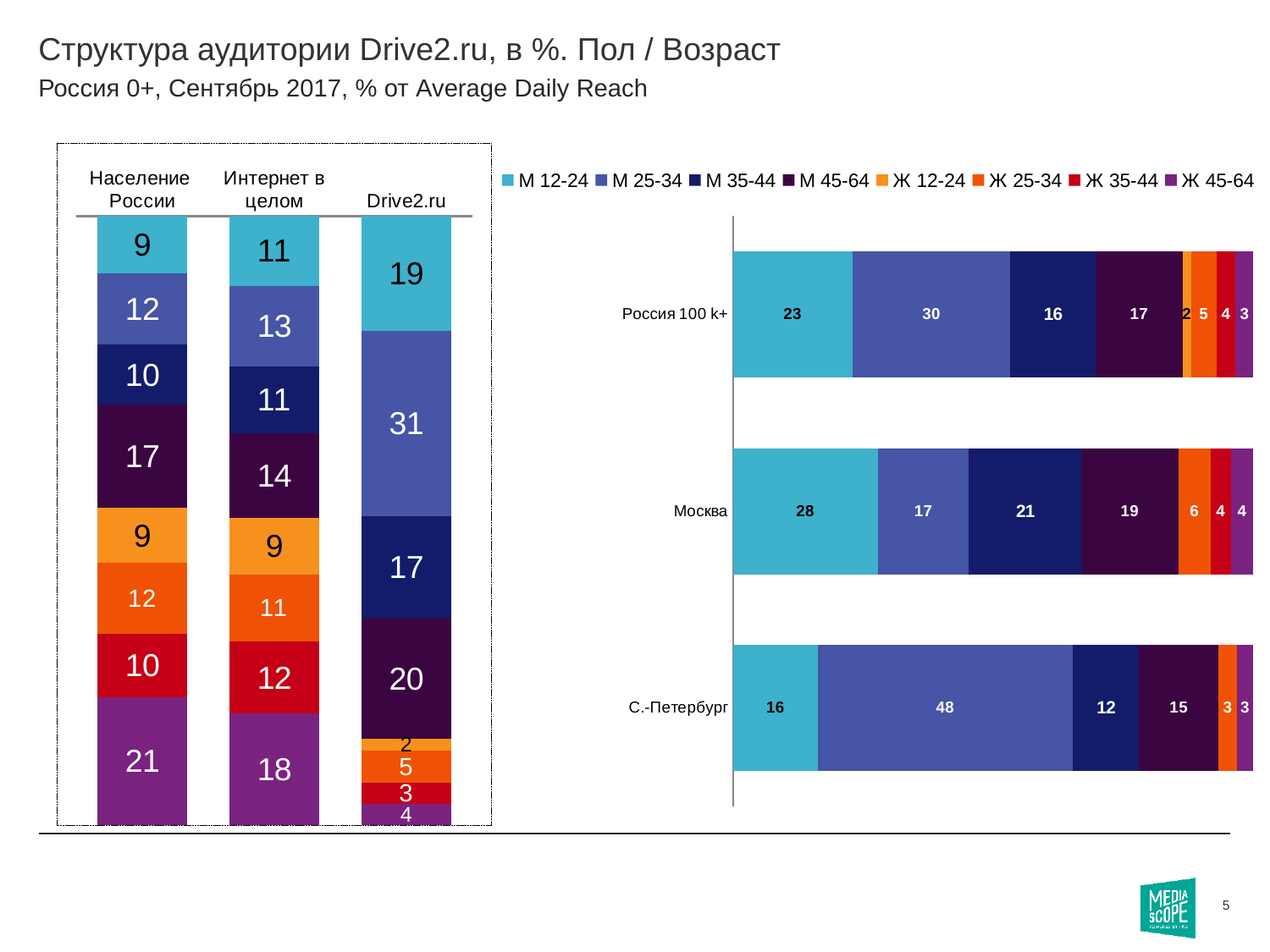
What kind of chart is the right chart? Stacked horizontal bar chart In the left chart, what is the value for Ж 45-64 in the Население России bar? 21 In the right chart, which is larger for Москва: М 35-44 or М 25-34? М 35-44 In the right chart, which city or region has the highest value for М 25-34? С.-Петербург In the left chart, which segment is the largest in the Drive2.ru bar? М 25-34 In the left chart, what is the value for М 25-34 in the Drive2.ru bar? 31 In the right chart, what is the value for М 25-34 for С.-Петербург? 48 In the left chart, which segment is the smallest in the Drive2.ru bar? Ж 12-24 In the right chart, what is the value for М 12-24 for Москва? 28 In the left chart, what is the difference between the М 25-34 values for Drive2.ru and Интернет в целом? 18 How many categories are shown in the right chart? 3 How many series does the legend list? 8